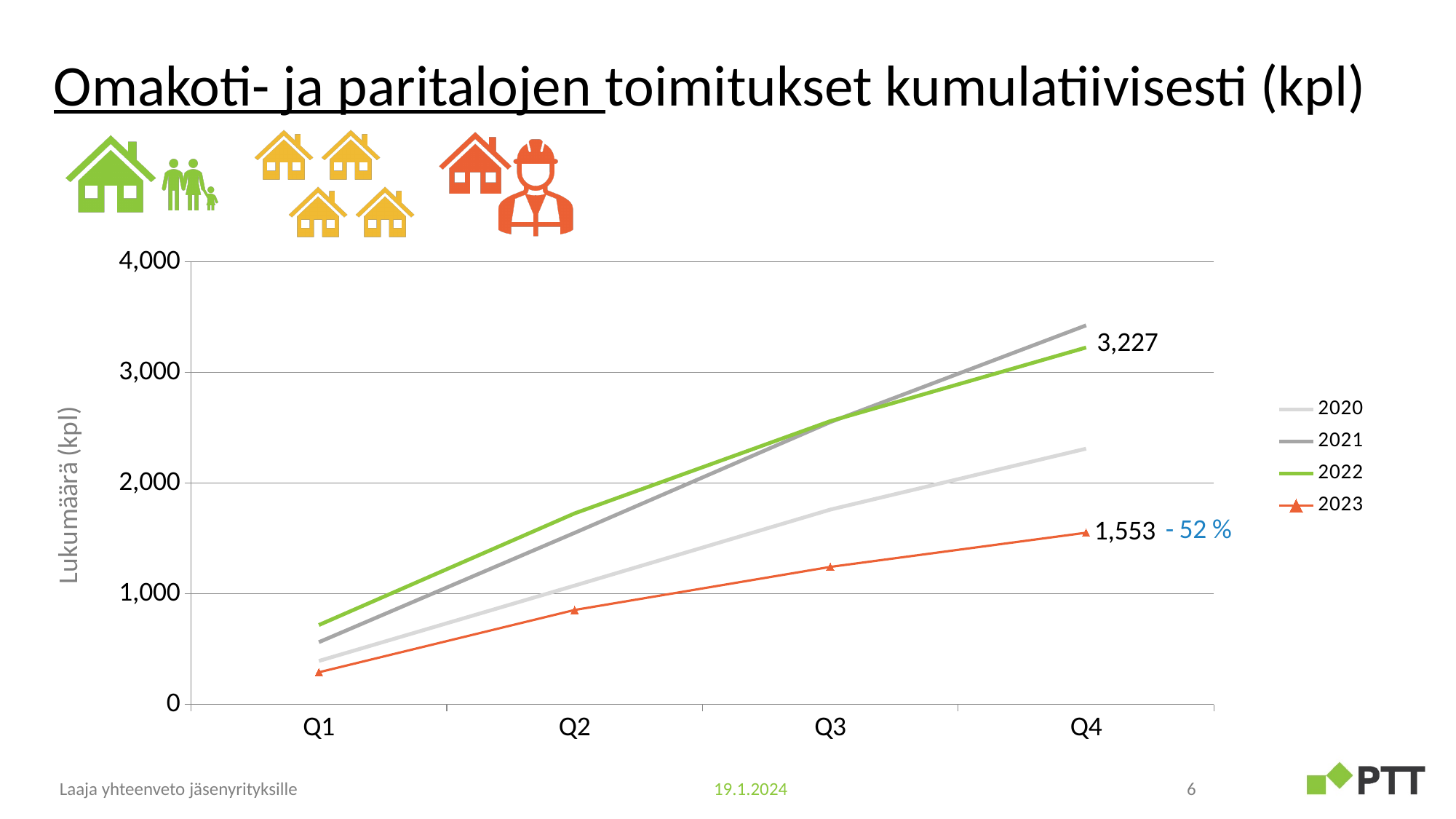
Which series has the larger value at Q4, 2022 or 2023? 2022 What is the value for the 2023 series at Q4? 1,553 Is the value for the 2023 series at Q1 greater or less than 1,000? less What kind of chart is shown on the slide? Line chart Is the value for the 2021 series at Q4 greater or less than 3,000? greater Which series has the lowest value at Q4? 2023 How many quarters are shown on the x axis? 4 Do the values of the 2023 series rise or fall from Q1 to Q4? Rise How many series does the legend list? 4 Which series has the highest value at Q4? 2021 What is the difference between the 2022 and 2023 values at Q4? 1,674 What is the value for the 2022 series at Q4? 3,227